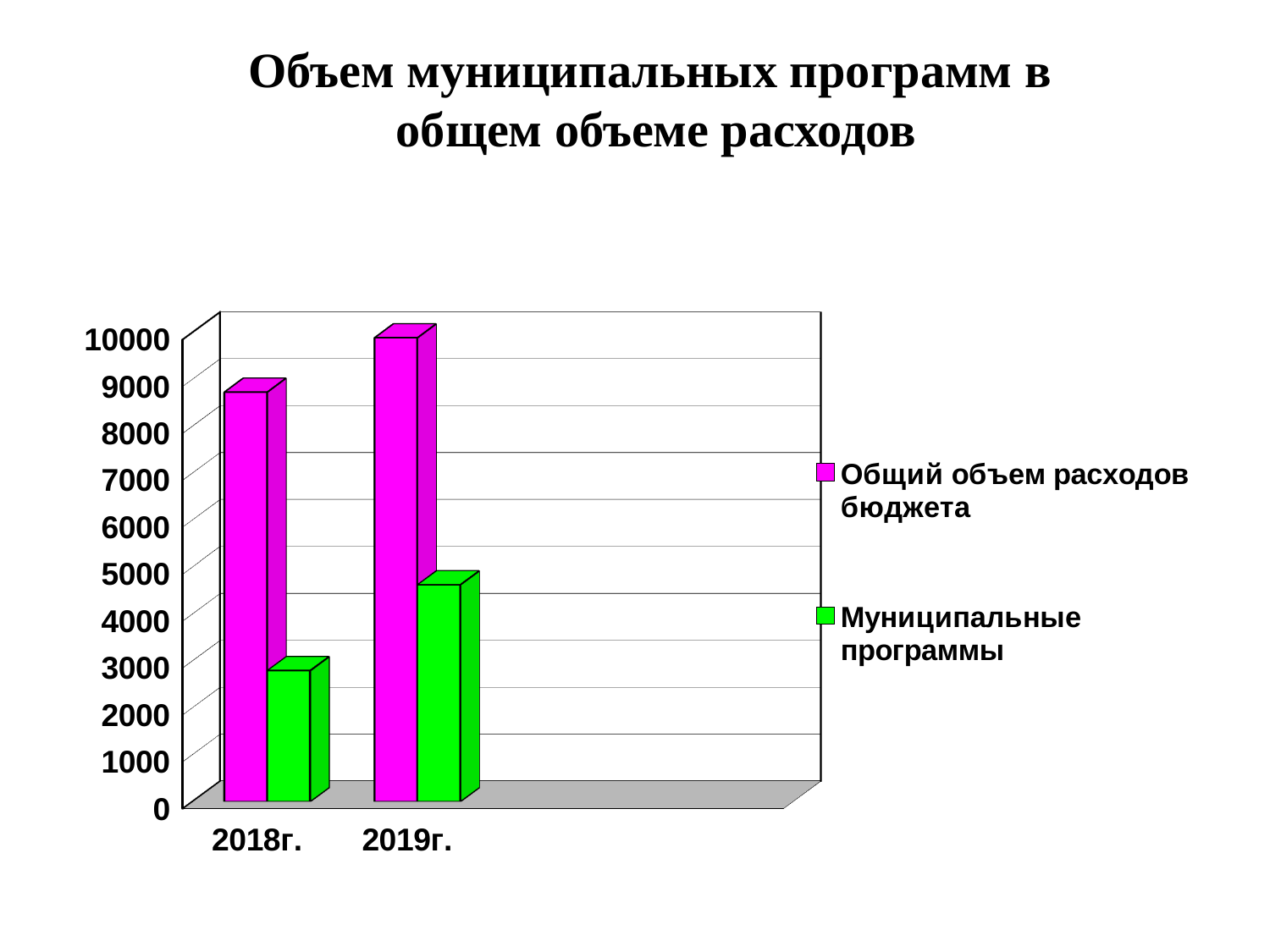
How many years (categories) are shown on the x axis? 2 What colour are the bars for Общий объем расходов бюджета? magenta (pink) Is the value for Общий объем расходов бюджета in 2019г. greater or less than 9000? greater Is the value for Муниципальные программы in 2019г. greater or less than 4000? greater Do the values for Муниципальные программы rise or fall from 2018г. to 2019г.? rise Is the value for Общий объем расходов бюджета in 2018г. greater or less than 8000? greater Which year has the higher value for Общий объем расходов бюджета? 2019г. Which year has the lower value for Муниципальные программы? 2018г. Which is larger: Муниципальные программы in 2018г. or in 2019г.? 2019г. What kind of chart is shown on the slide? bar chart How many series does the legend list? 2